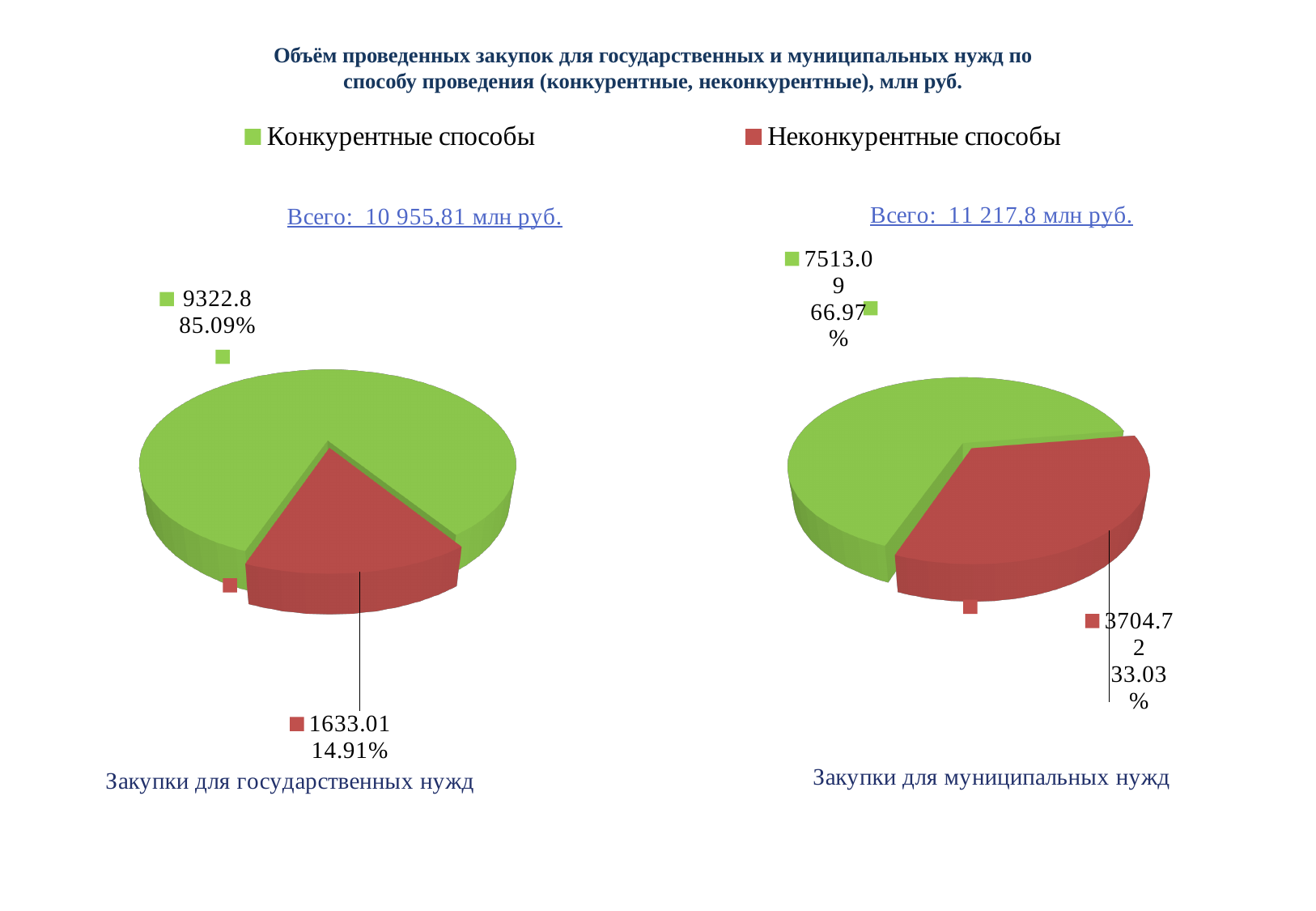
In the right chart (Закупки для муниципальных нужд), what is the value for Неконкурентные способы? 3704.72 What type of chart is used on this slide? Pie chart In the left chart (Закупки для государственных нужд), what share of the pie is Неконкурентные способы? 14.91% In the left chart (Закупки для государственных нужд), which category is the smallest? Неконкурентные способы In the right chart (Закупки для муниципальных нужд), what share of the pie is Конкурентные способы? 66.97% In the left chart (Закупки для государственных нужд), what is the value for Конкурентные способы? 9322.8 In the left chart (Закупки для государственных нужд), what is the difference between Конкурентные способы and Неконкурентные способы? 7689.79 In the right chart (Закупки для муниципальных нужд), what is the value for Конкурентные способы? 7513.09 Which is larger: Неконкурентные способы in the left chart or Неконкурентные способы in the right chart? Неконкурентные способы in the right chart In the left chart (Закупки для государственных нужд), what is the value for Неконкурентные способы? 1633.01 In the right chart (Закупки для муниципальных нужд), which category is the largest? Конкурентные способы What total (Всего) is shown above the right chart (Закупки для муниципальных нужд)? 11 217,8 млн руб.